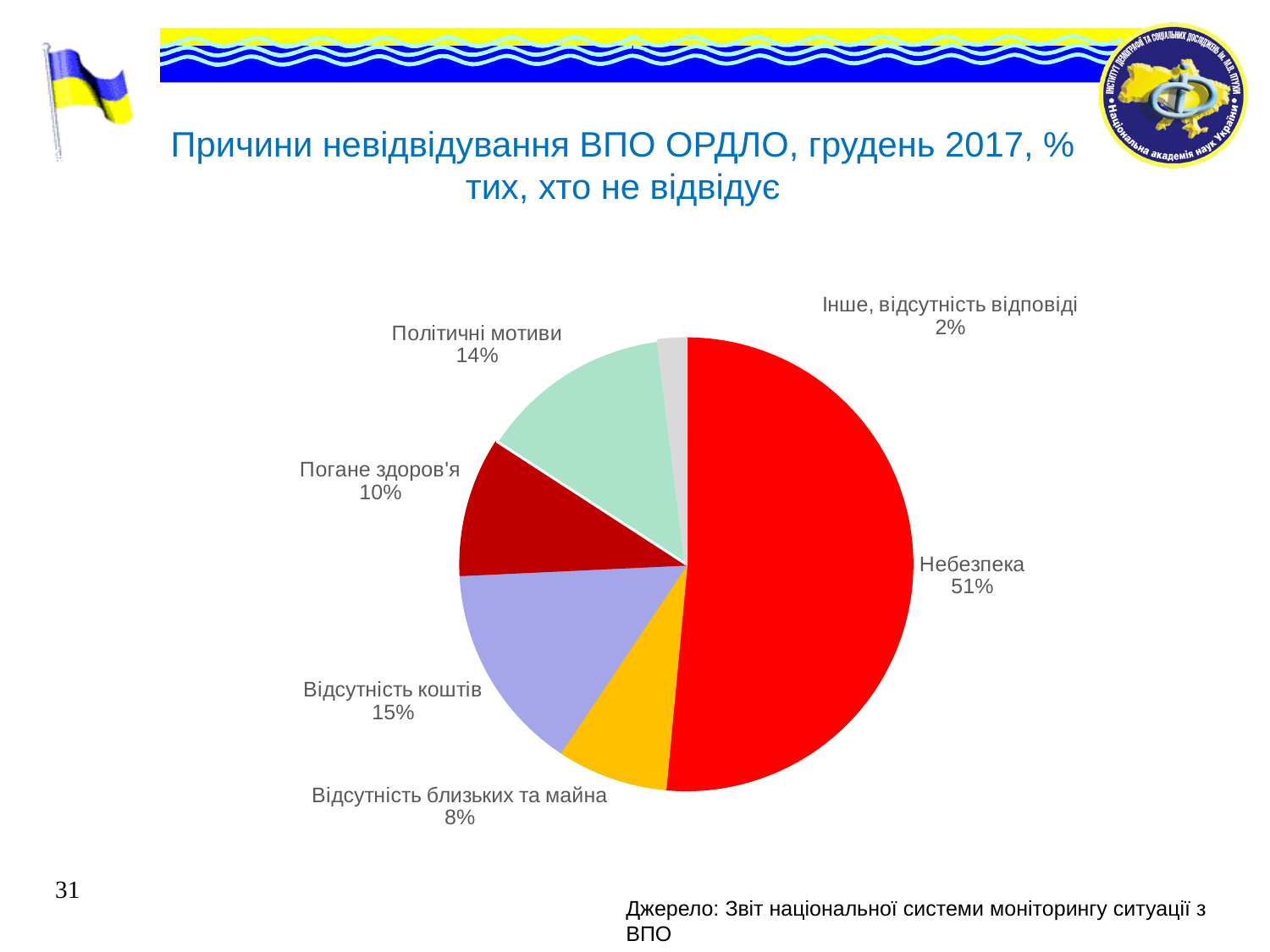
How many slices does the pie chart have? 6 Which category has the smallest slice of the pie? Інше, відсутність відповіді What is the value for "Політичні мотиви"? 14% Which category has the largest slice of the pie? Небезпека What is the difference between the values for "Небезпека" and "Відсутність коштів"? 36% What is the title of the chart on the slide? Причини невідвідування ВПО ОРДЛО, грудень 2017, % тих, хто не відвідує What is the value for "Відсутність близьких та майна"? 8% What is the value for "Погане здоров'я"? 10% What is the value for "Відсутність коштів"? 15% What kind of chart is shown on the slide? pie chart What share of the pie does "Небезпека" have? 51% Which is larger, the value for "Політичні мотиви" or the value for "Погане здоров'я"? Політичні мотиви